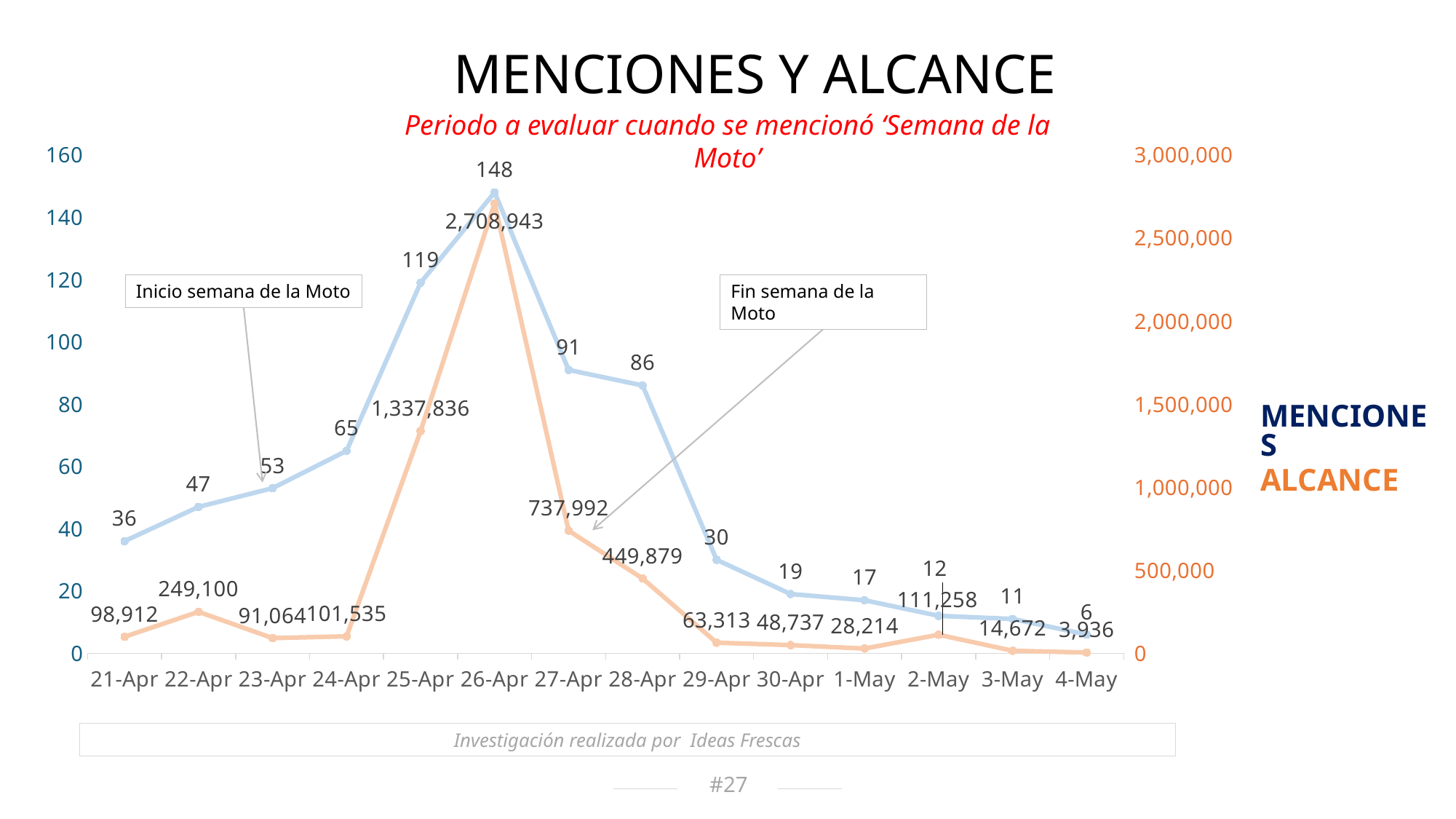
What is the title of the chart? MENCIONES Y ALCANCE Which date has a higher Alcance value, 22-Apr or 2-May? 22-Apr What is the Menciones value on 26-Apr? 148 On which date is Alcance highest? 26-Apr What type of chart is shown on the slide? line chart Do the Menciones values rise or fall from 26-Apr to 4-May? fall What is the difference in Menciones between 26-Apr and 25-Apr? 29 What is the Alcance value on 25-Apr? 1,337,836 What is the Menciones value on 21-Apr? 36 How many dates are plotted along the x axis? 14 On which date is Menciones lowest? 4-May How many series does the legend list? 2